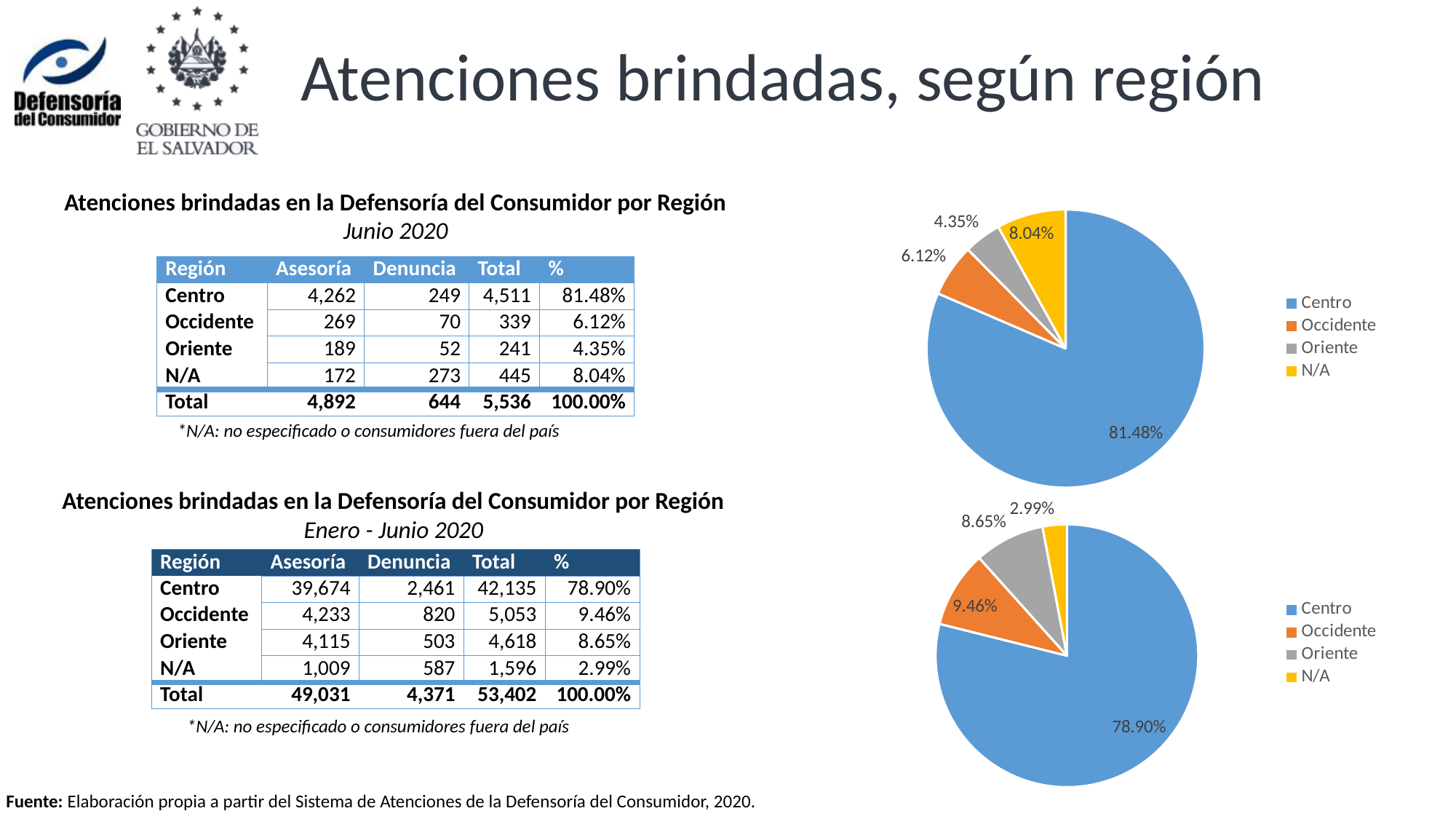
In the top pie chart on the right, which region has the largest slice? Centro In the bottom pie chart on the right, what is the difference between the Centro and N/A shares? 75.91% What type of chart is shown at the bottom right of the slide? Pie chart In the bottom pie chart on the right, what share does Occidente have? 9.46% How many entries does the legend of the top pie chart on the right list? 4 In the top pie chart on the right, which region has the smallest slice? Oriente In the top pie chart on the right, what share does N/A have? 8.04% In the top pie chart on the right, what is the difference between the Occidente and Oriente shares? 1.77% In the bottom pie chart on the right, what share does Oriente have? 8.65% In the bottom pie chart on the right, which region has the smallest slice? N/A In the bottom pie chart on the right, which is larger, the Occidente slice or the N/A slice? Occidente In the top pie chart on the right, what share does Centro have? 81.48%